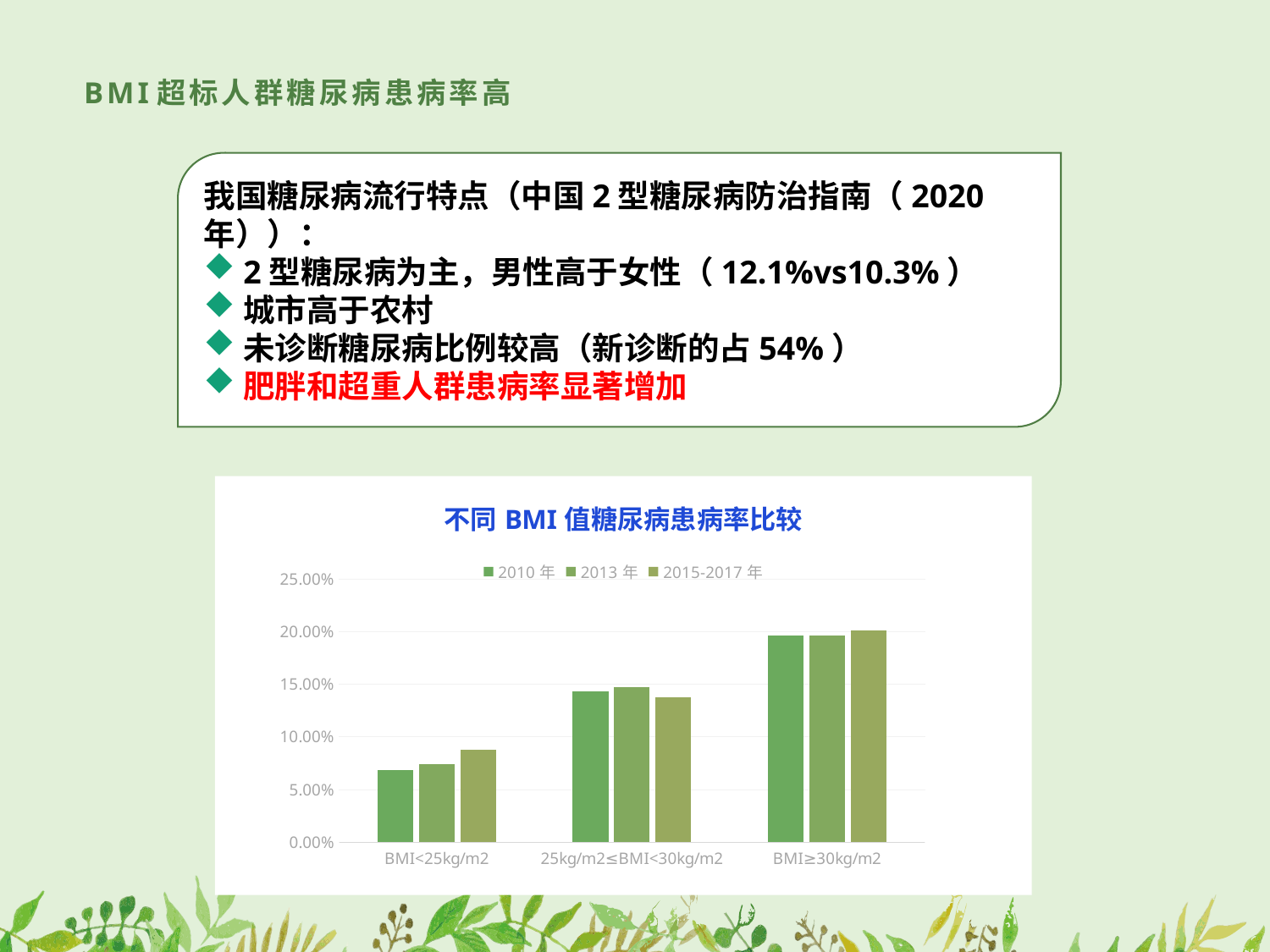
How many series does the chart legend list? 3 Is the 2013 年 value for BMI<25kg/m2 greater or less than 10.00%? less Which BMI category has the highest diabetes prevalence across all series? BMI≥30kg/m2 Which series does the legend list last? 2015-2017 年 For the 2010 年 series, which is larger: the value for BMI<25kg/m2 or the value for 25kg/m2≤BMI<30kg/m2? 25kg/m2≤BMI<30kg/m2 How many BMI categories are shown on the x axis? 3 Is the 2010 年 value for BMI≥30kg/m2 greater or less than 15.00%? greater What is the title of the chart? 不同 BMI 值糖尿病患病率比较 Is the 2015-2017 年 value for 25kg/m2≤BMI<30kg/m2 greater or less than 10.00%? greater Which BMI category has the lowest diabetes prevalence across all series? BMI<25kg/m2 What kind of chart is shown on the slide? bar chart